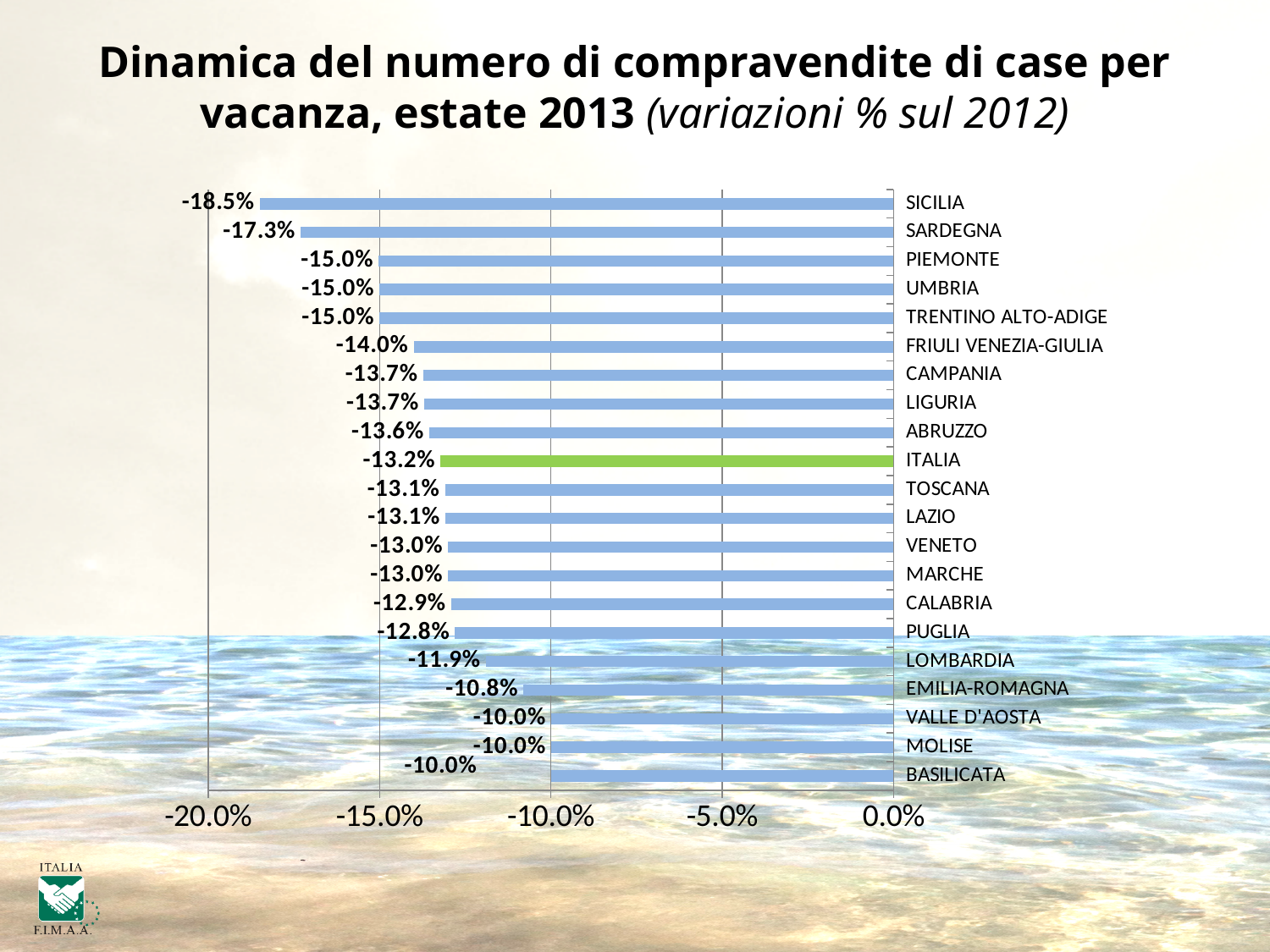
What kind of chart is shown on the slide? Bar chart What is the value for EMILIA-ROMAGNA? -10.8% How many categories are shown in the chart? 21 What is the difference between the values for SICILIA and SARDEGNA? 1.2 percentage points What is the value for ITALIA? -13.2% What is the value for SICILIA? -18.5% Which has the larger (less negative) value, PIEMONTE or CAMPANIA? CAMPANIA Which has the more negative value, SARDEGNA or FRIULI VENEZIA-GIULIA? SARDEGNA Which category has the lowest (most negative) value? SICILIA Which bar is shown in a different colour (green) from the others? ITALIA What is the value for LOMBARDIA? -11.9% What is the difference between the values for ITALIA and LOMBARDIA? 1.3 percentage points